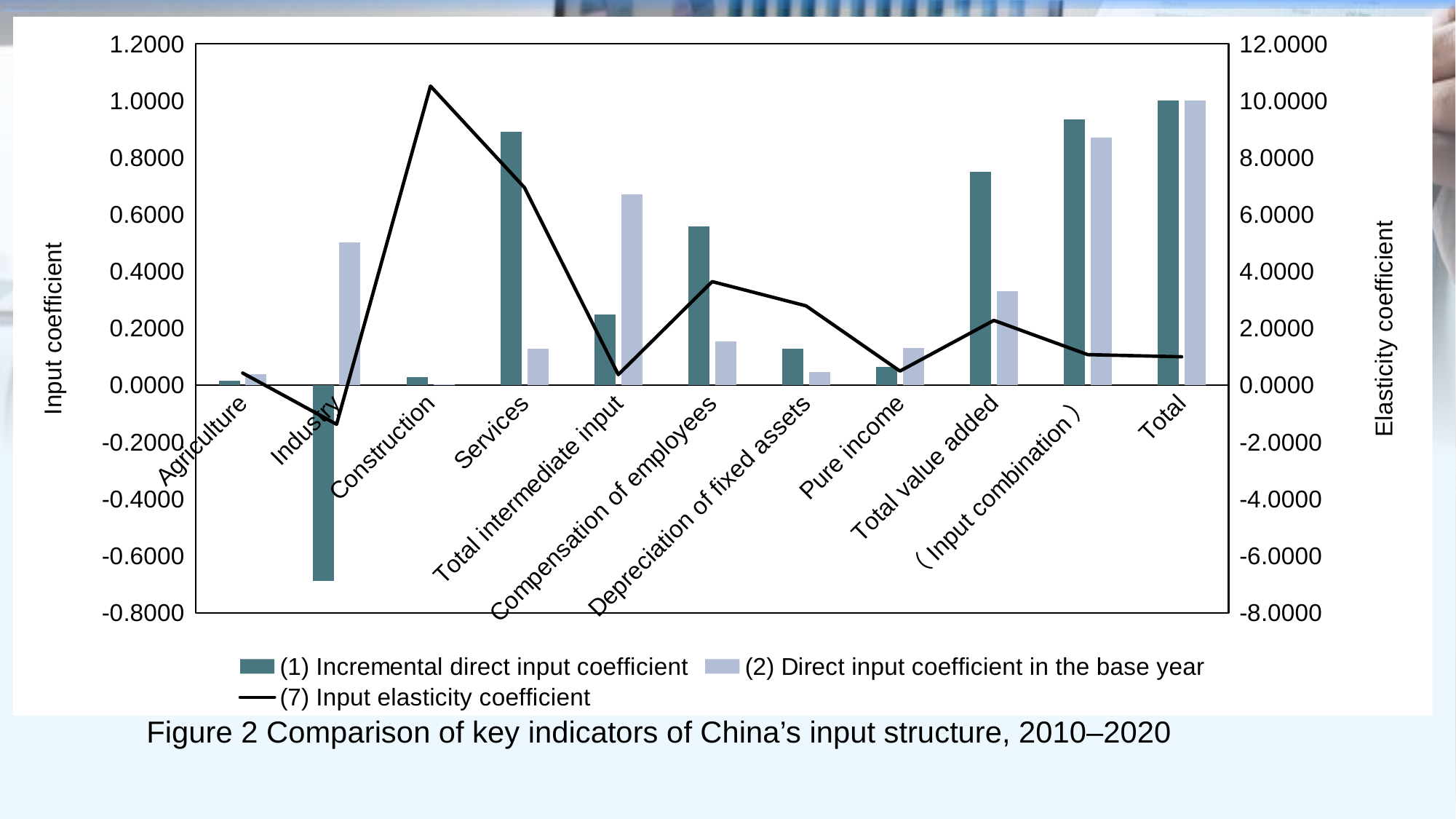
How many series does the legend list? 3 For Total intermediate input, which is larger: the (1) Incremental direct input coefficient or the (2) Direct input coefficient in the base year? (2) Direct input coefficient in the base year Is the (7) Input elasticity coefficient for Construction greater or less than 10.0000? greater How many categories are shown along the x axis? 11 Which category has the lowest value on the (7) Input elasticity coefficient line? Industry What is the caption of the figure shown on the slide? Figure 2 Comparison of key indicators of China's input structure, 2010–2020 Which category has the highest value for the (1) Incremental direct input coefficient series? Total Which category has the highest value on the (7) Input elasticity coefficient line? Construction Which category has the lowest value for the (1) Incremental direct input coefficient series? Industry Is the (1) Incremental direct input coefficient for Services greater or less than 0.8000? greater What kind of chart is shown on the slide? Combined bar and line chart For Compensation of employees, which is larger: the (1) Incremental direct input coefficient or the (2) Direct input coefficient in the base year? (1) Incremental direct input coefficient